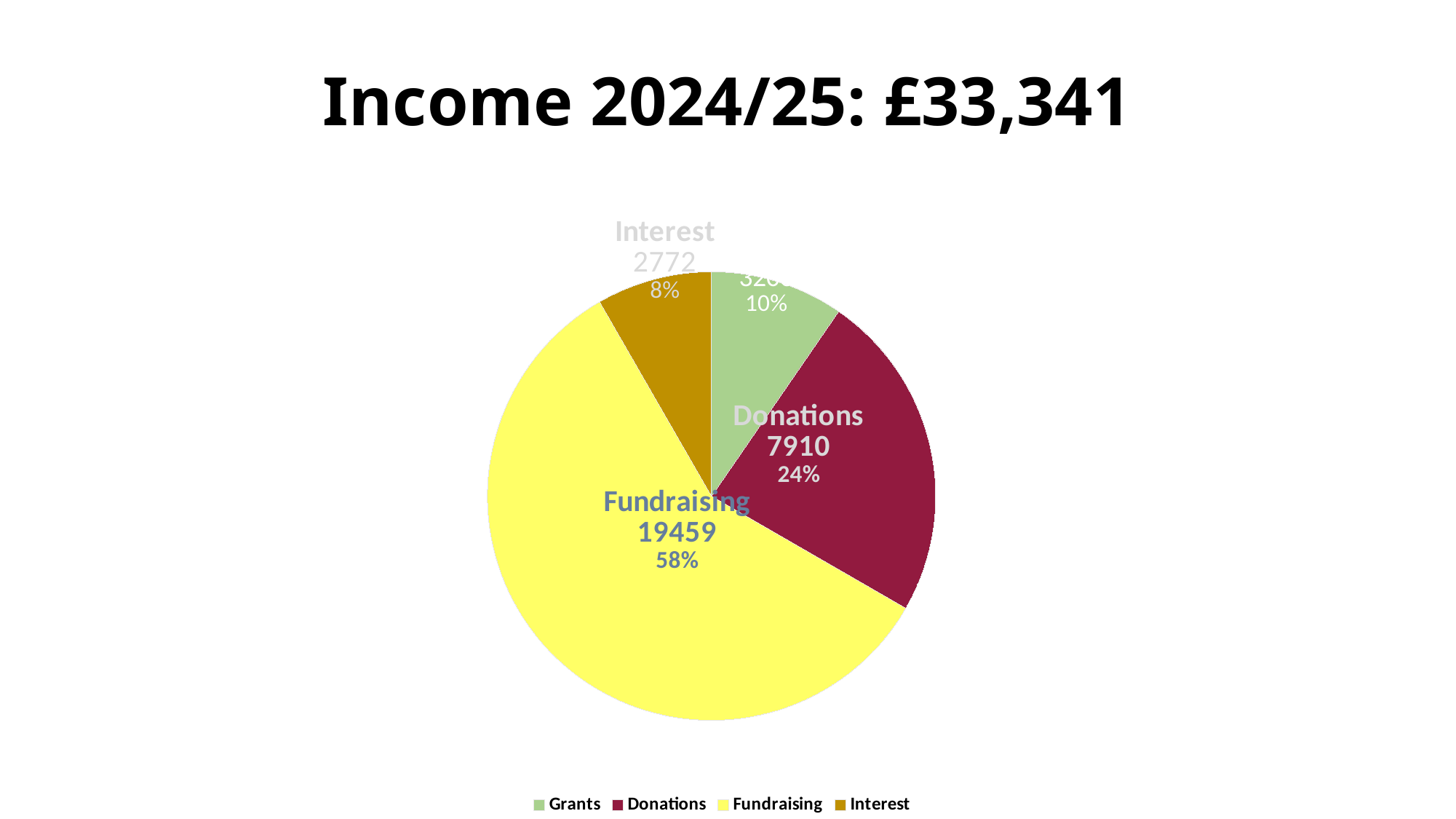
What is the value for Interest? 2772 How many categories does the pie chart show? 4 Which category has the largest slice of the pie? Fundraising What share of the pie does Donations represent? 24% What total income is stated in the chart title? £33,341 What is the difference between the Fundraising value and the Donations value? 11549 Which category has the smallest slice of the pie? Interest What kind of chart is shown on the slide? pie chart What share of the pie does Fundraising represent? 58% What is the value for Fundraising? 19459 What is the value for Donations? 7910 What share of the pie does Grants represent? 10%